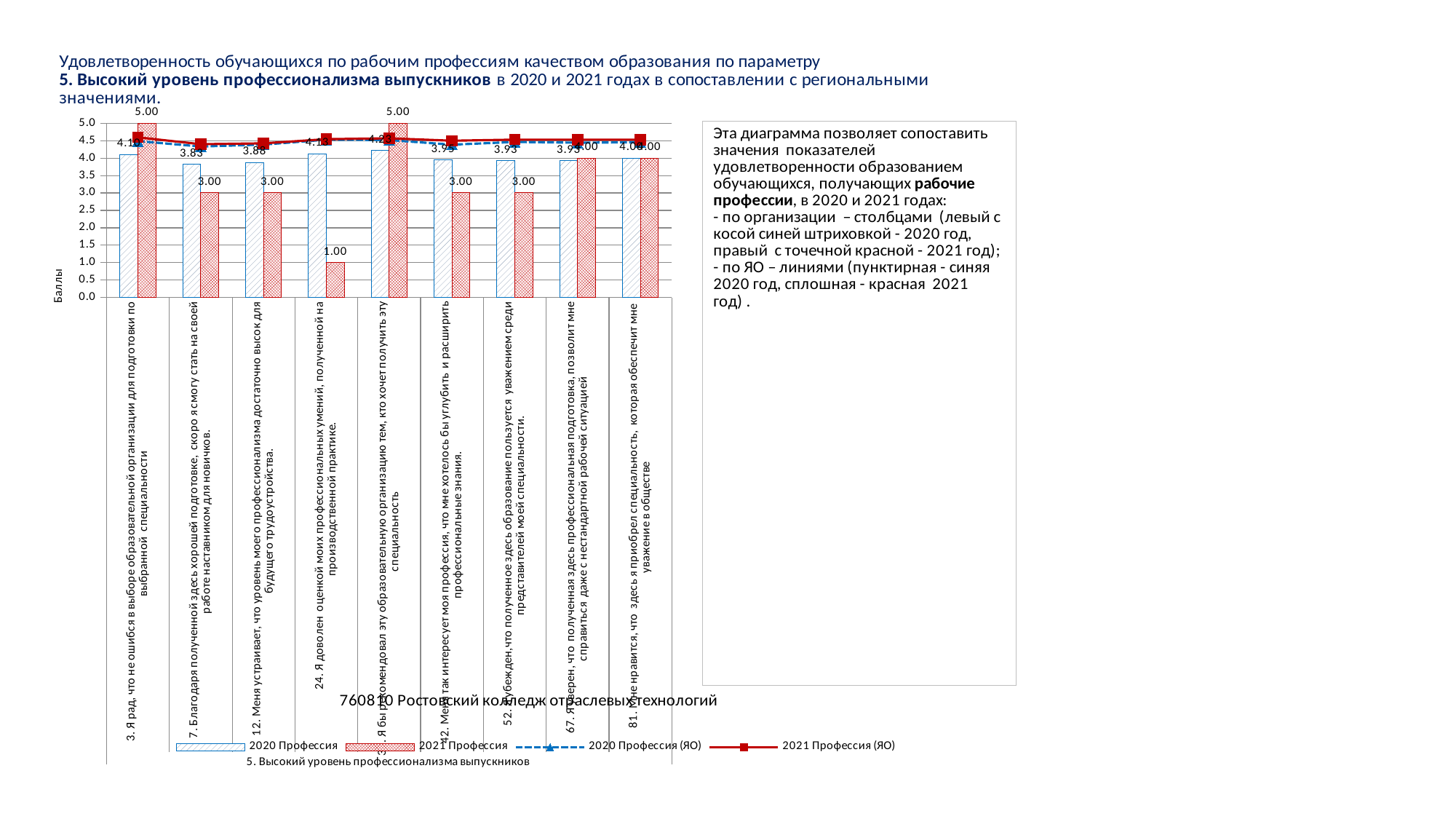
Which statement has the lowest 2021 Профессия bar? 24. Я доволен оценкой моих профессиональных умений, полученной на производственной практике What is the title of the vertical axis? Баллы What is the 2021 Профессия value for statement 7 (Благодаря полученной здесь хорошей подготовке...)? 3.00 What is the 2021 Профессия value for statement 24 (Я доволен оценкой моих профессиональных умений...)? 1.00 What is the 2020 Профессия value for statement 42 (Меня так интересует моя профессия...)? 3.95 How many statement categories are plotted along the x axis? 9 What is the difference between the 2020 Профессия and 2021 Профессия values for statement 7? 0.83 What is the 2020 Профессия value for statement 3 (Я рад, что не ошибся в выборе образовательной организации...)? 4.10 How many series does the chart legend list? 4 For statement 3, which is larger: the 2020 Профессия value or the 2021 Профессия value? 2021 Профессия What kind of chart is shown on the slide? A combined bar and line chart Is the 2021 Профессия value for statement 24 greater or less than 2.0? less